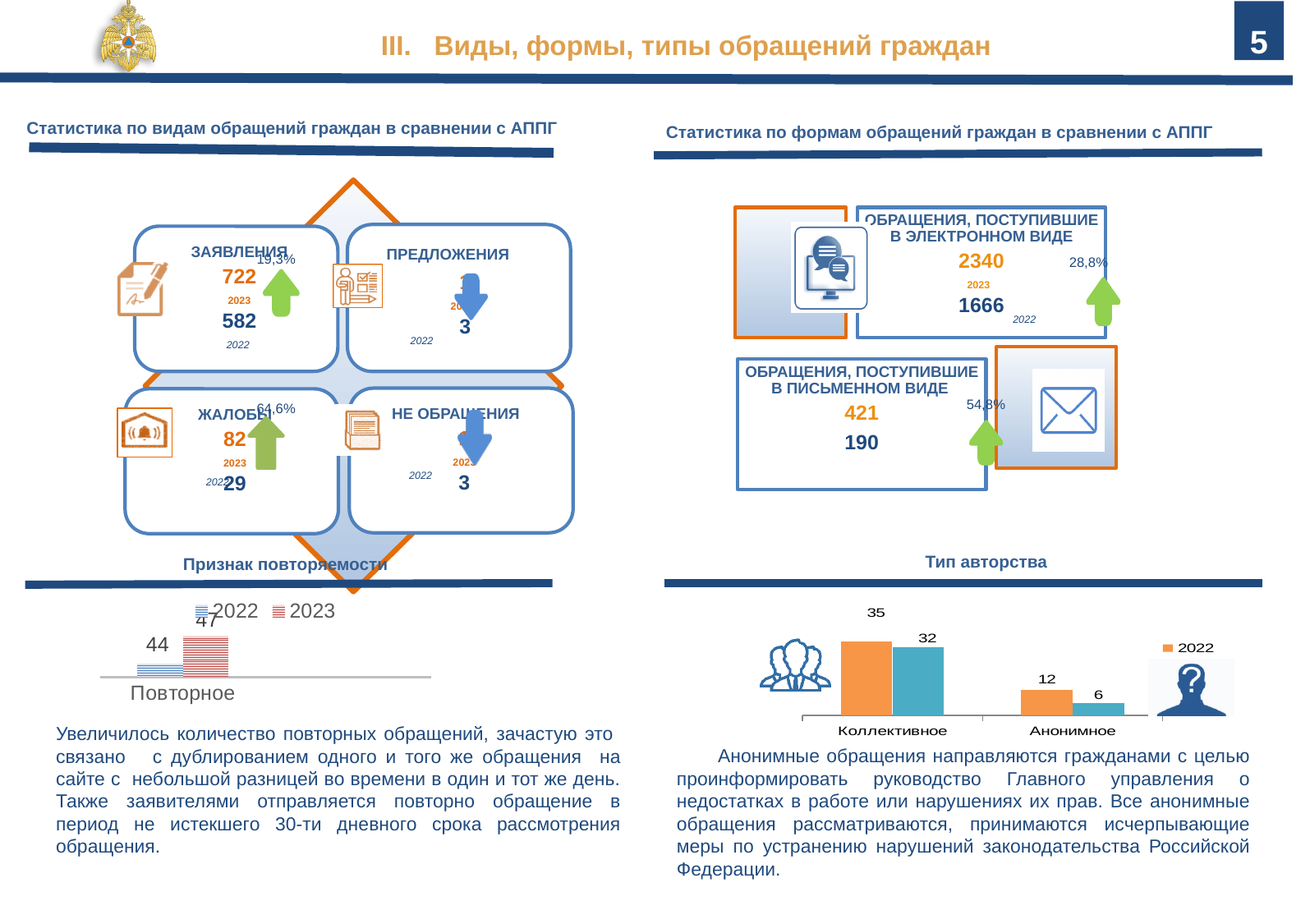
In the "Тип авторства" chart, which category has the higher 2022 value? Коллективное In the "Тип авторства" chart, what is the 2022 value for Анонимное? 12 What kind of chart is the "Признак повторяемости" chart? bar chart How many categories are shown on the x axis of the "Тип авторства" chart? 2 In the "Тип авторства" chart, what is the difference between the 2022 values for Коллективное and Анонимное? 23 In the "Признак повторяемости" chart, what is the value for 2022? 44 In the "Тип авторства" chart, what is the 2022 value for Коллективное? 35 In the "Признак повторяемости" chart, which is larger, the 2022 value or the 2023 value? 2023 How many categories are shown on the x axis of the "Признак повторяемости" chart? 1 In the "Признак повторяемости" chart, what is the value for 2023? 47 How many series does the legend of the "Признак повторяемости" chart list? 2 In the "Признак повторяемости" chart, what is the difference between the 2023 and 2022 values? 3